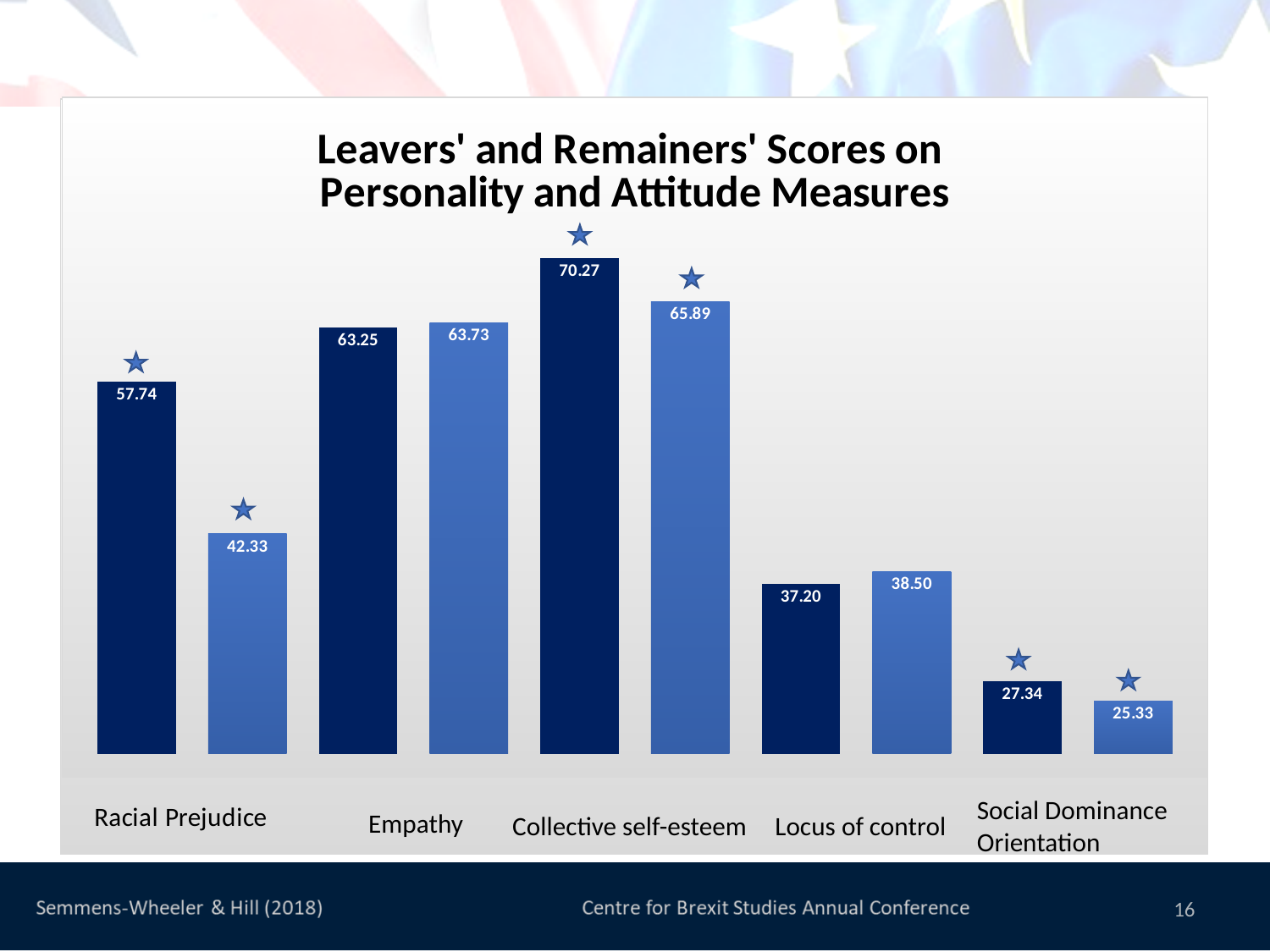
Which bar has the lowest value on the chart? The light blue bar for Social Dominance Orientation (25.33) What is the value of the dark blue bar for Racial Prejudice? 57.74 What is the title of the chart? Leavers' and Remainers' Scores on Personality and Attitude Measures What is the value of the light blue bar for Collective self-esteem? 65.89 What kind of chart is shown on the slide? Bar chart How many measures (categories) are shown on the x axis? 5 For Locus of control, which bar is larger, the dark blue or the light blue? The light blue bar (38.50) What is the difference between the dark blue and light blue bars for Collective self-esteem? 4.38 What is the difference between the dark blue and light blue bars for Racial Prejudice? 15.41 What is the value of the light blue bar for Empathy? 63.73 What is the difference between the dark blue and light blue bars for Social Dominance Orientation? 2.01 Which bar has the highest value on the chart? The dark blue bar for Collective self-esteem (70.27)